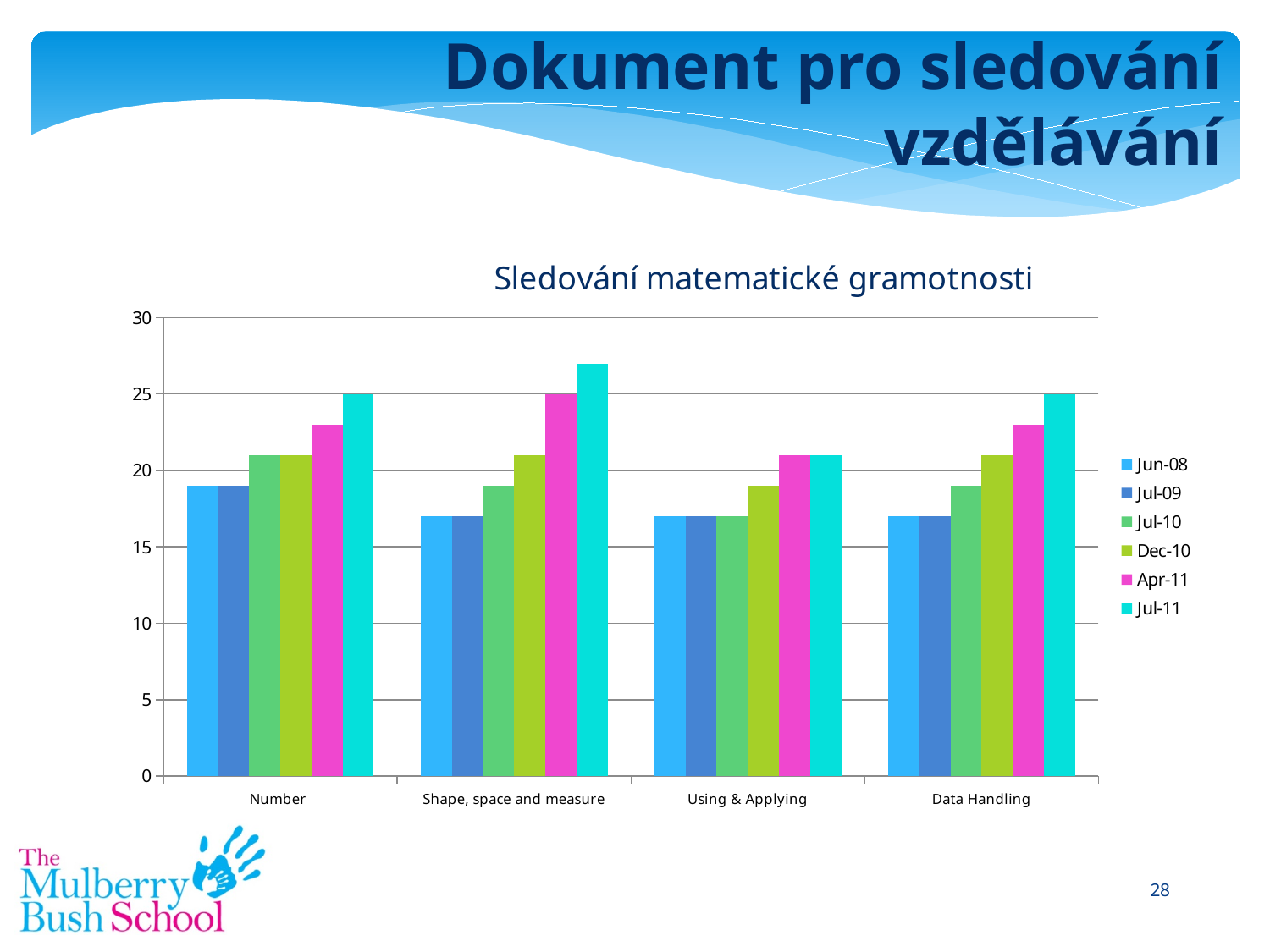
Is the value for Jul-11 in the Shape, space and measure category greater or less than 25? greater How many series does the legend list? 6 What is the value for Jul-11 in the Number category? 25 Which is larger: the Jul-11 value for Shape, space and measure or the Jul-11 value for Number? Shape, space and measure In the Number category, do the values rise or fall from Jun-08 to Jul-11? rise Which category has the lowest Jul-11 value? Using & Applying Is the value for Jun-08 in the Number category greater or less than 20? less What type of chart is shown on the slide? bar chart What is the value for Apr-11 in the Shape, space and measure category? 25 How many categories are shown on the x axis? 4 Which category has the highest Jul-11 value? Shape, space and measure What is the title of the chart? Sledování matematické gramotnosti